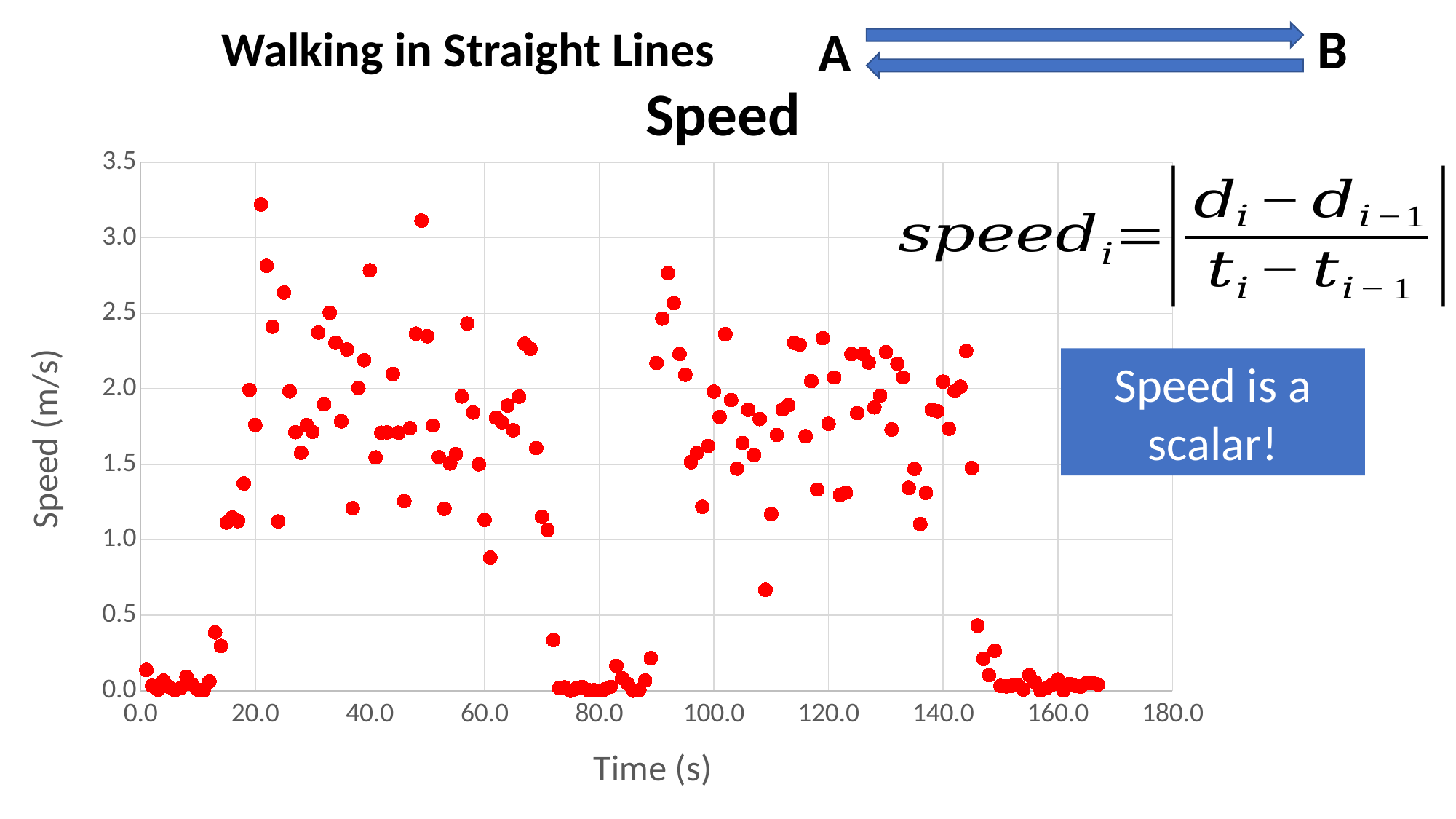
Are the speed values plotted between 155 s and 165 s greater or less than 0.5? less What is the title of the chart? Speed Are the speed values plotted between 0 s and 10 s greater or less than 0.5? less What is the label of the vertical axis of the chart? Speed (m/s) What is the highest value shown on the vertical axis of the chart? 3.5 What kind of chart is shown on the slide? scatter chart